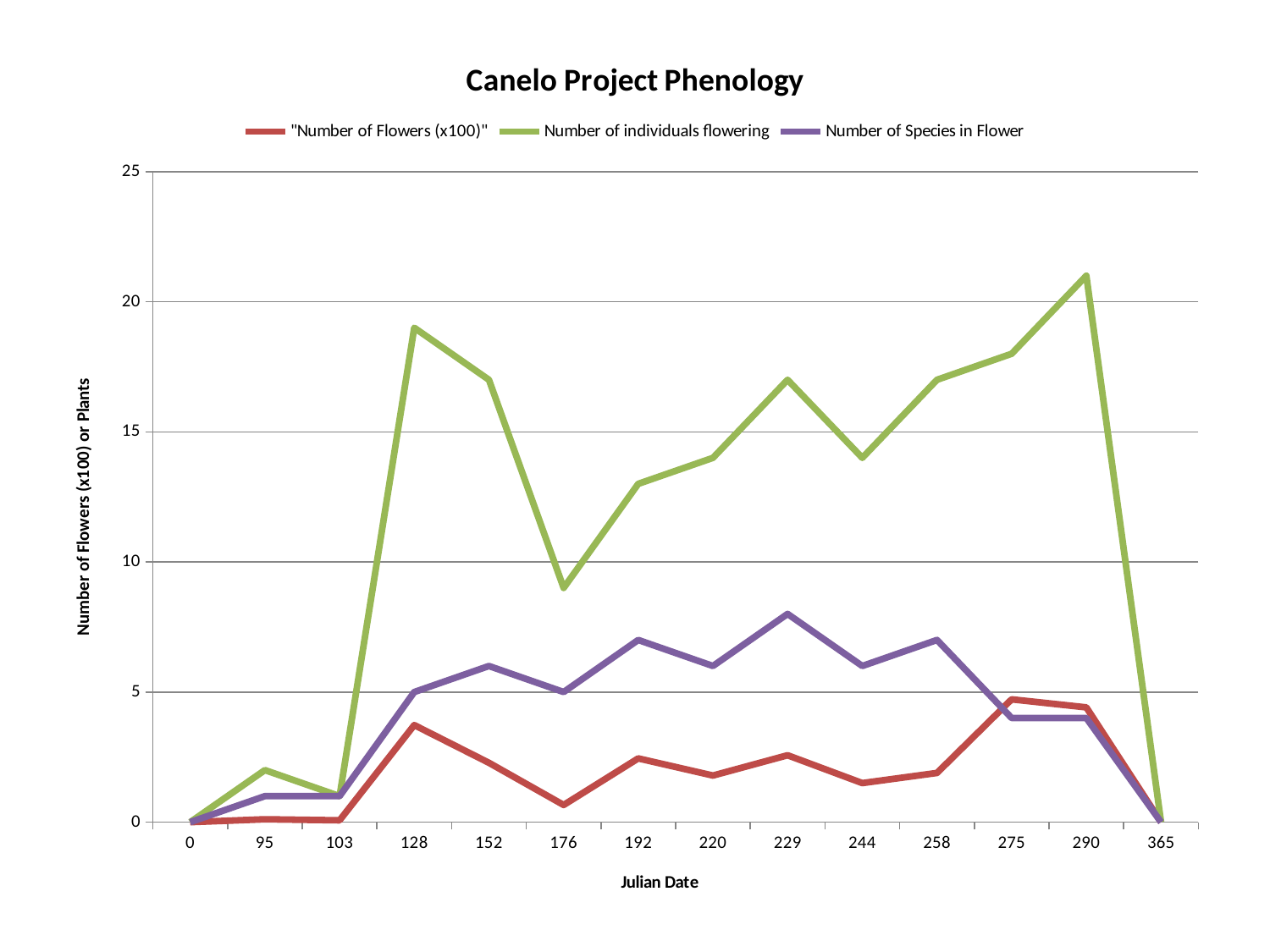
Is the Number of Species in Flower at Julian Date 229 greater or less than 5? greater What is the Number of Species in Flower at Julian Date 128? 5 What kind of chart is shown on the slide? line chart At which Julian Date does the Number of individuals flowering reach its highest value? 290 What is the title of the chart? Canelo Project Phenology At Julian Date 220, which is larger: Number of individuals flowering or Number of Species in Flower? Number of individuals flowering What is the Number of individuals flowering at Julian Date 365? 0 How many Julian Date points are plotted along the x axis? 14 Is the Number of individuals flowering at Julian Date 176 greater or less than 10? less How many series does the legend list? 3 Is the Number of individuals flowering at Julian Date 290 greater or less than 20? greater